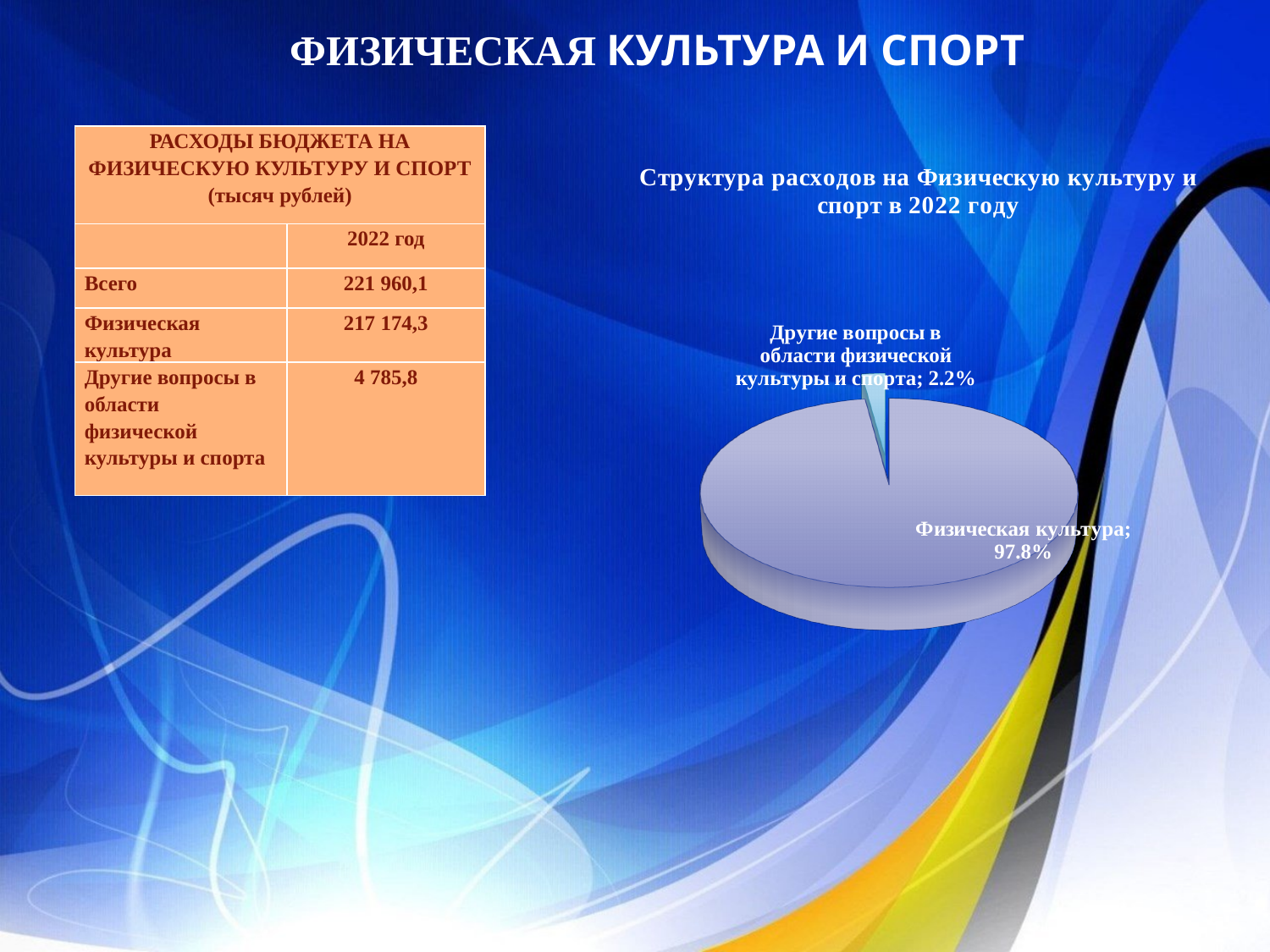
What share of the pie does "Другие вопросы в области физической культуры и спорта" have? 2.2% Which is larger in the pie chart: "Физическая культура" or "Другие вопросы в области физической культуры и спорта"? Физическая культура What share of the pie does "Физическая культура" have? 97.8% Is the share of "Физическая культура" in the pie chart greater or less than 90%? greater Which year does the pie chart describe? 2022 Is the share of "Другие вопросы в области физической культуры и спорта" in the pie chart greater or less than 10%? less Which slice of the pie chart is the largest? Физическая культура How many slices does the pie chart have? 2 Which slice of the pie chart is the smallest? Другие вопросы в области физической культуры и спорта What is the difference in percentage points between the "Физическая культура" slice and the "Другие вопросы в области физической культуры и спорта" slice? 95.6 What kind of chart is shown on the slide? Pie chart What is the title of the pie chart? Структура расходов на Физическую культуру и спорт в 2022 году